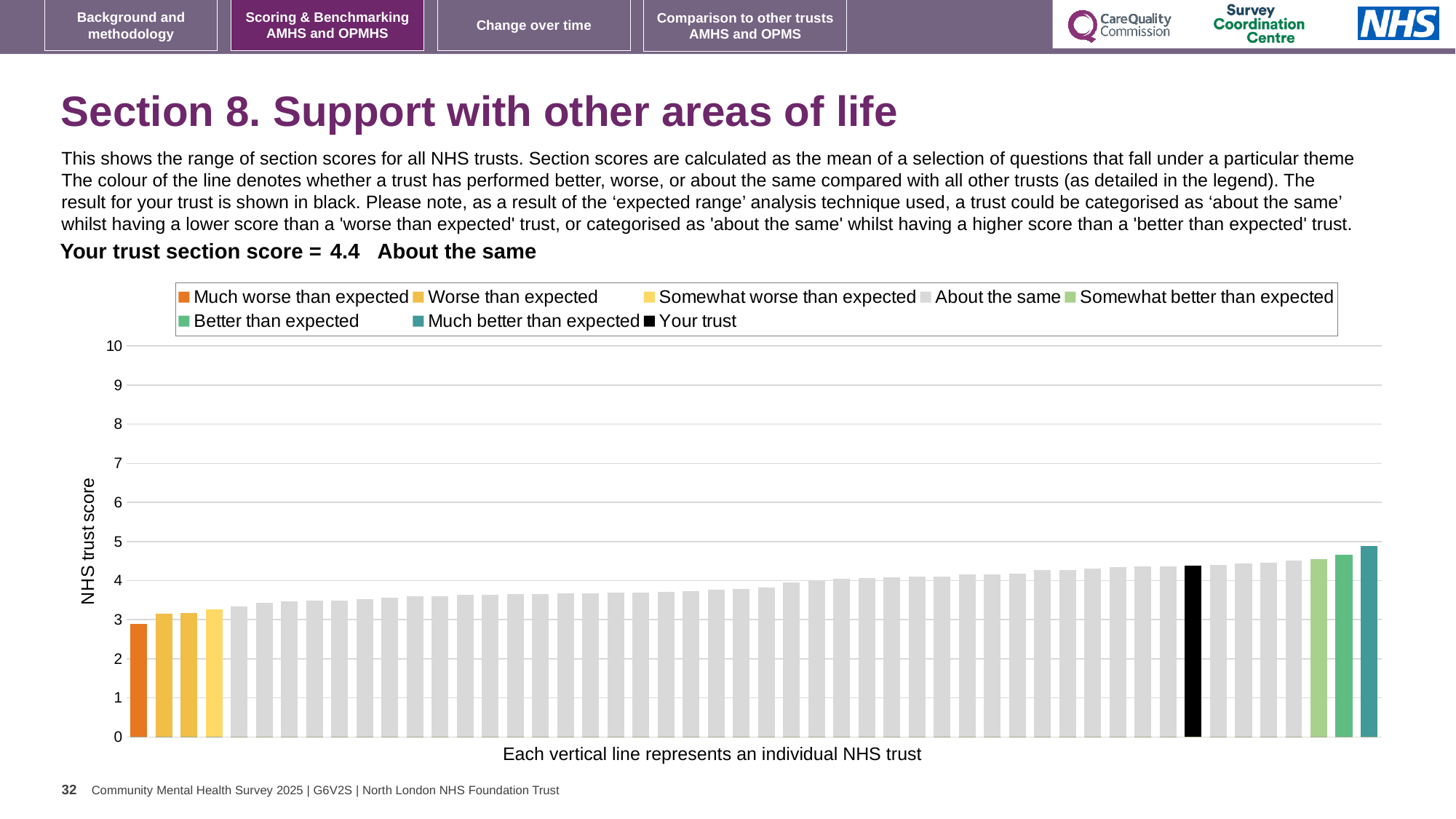
How many entries does the chart legend list? 8 What kind of chart is shown on the slide? bar chart Is the value for the rightmost bar greater or less than 4? greater Which category is your trust's section score placed in? About the same Do the bar values rise or fall from left to right along the x axis? rise Is the value for your trust's bar greater or less than 4? greater What is the label on the vertical axis of the chart? NHS trust score Is your trust's bar higher or lower than the rightmost bar? lower What is the section score for your trust? 4.4 Which legend category does the lowest bar belong to? Much worse than expected Is the value for the leftmost bar greater or less than 4? less Which legend category does the highest bar belong to? Much better than expected